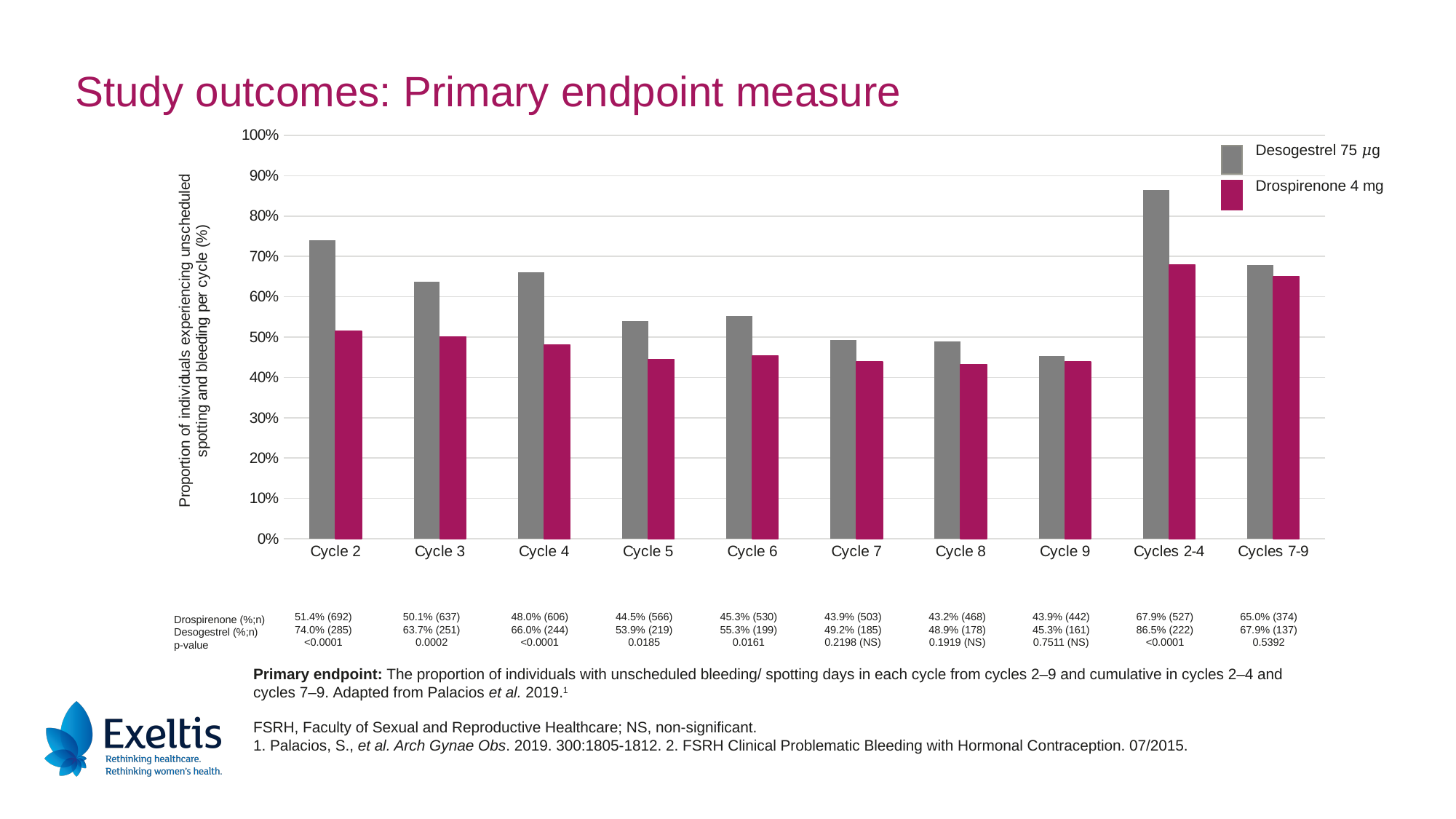
How many categories are shown on the x axis? 10 Which colour represents Drospirenone 4 mg in the chart? Magenta How many series does the legend list? 2 What is the value for Drospirenone 4 mg in Cycles 2-4? 67.9% What is the difference between Desogestrel 75 µg and Drospirenone 4 mg in Cycle 2? 22.6% Which is larger in Cycle 4, the value for Desogestrel 75 µg or Drospirenone 4 mg? Desogestrel 75 µg Which category has the highest value for Desogestrel 75 µg? Cycles 2-4 What is the value for Drospirenone 4 mg in Cycle 5? 44.5% What is the value for Desogestrel 75 µg in Cycle 2? 74.0% Which category has the lowest value for Drospirenone 4 mg? Cycle 8 Is the value for Desogestrel 75 µg in Cycles 2-4 greater or less than 80%? greater What type of chart is shown on the slide? Bar chart